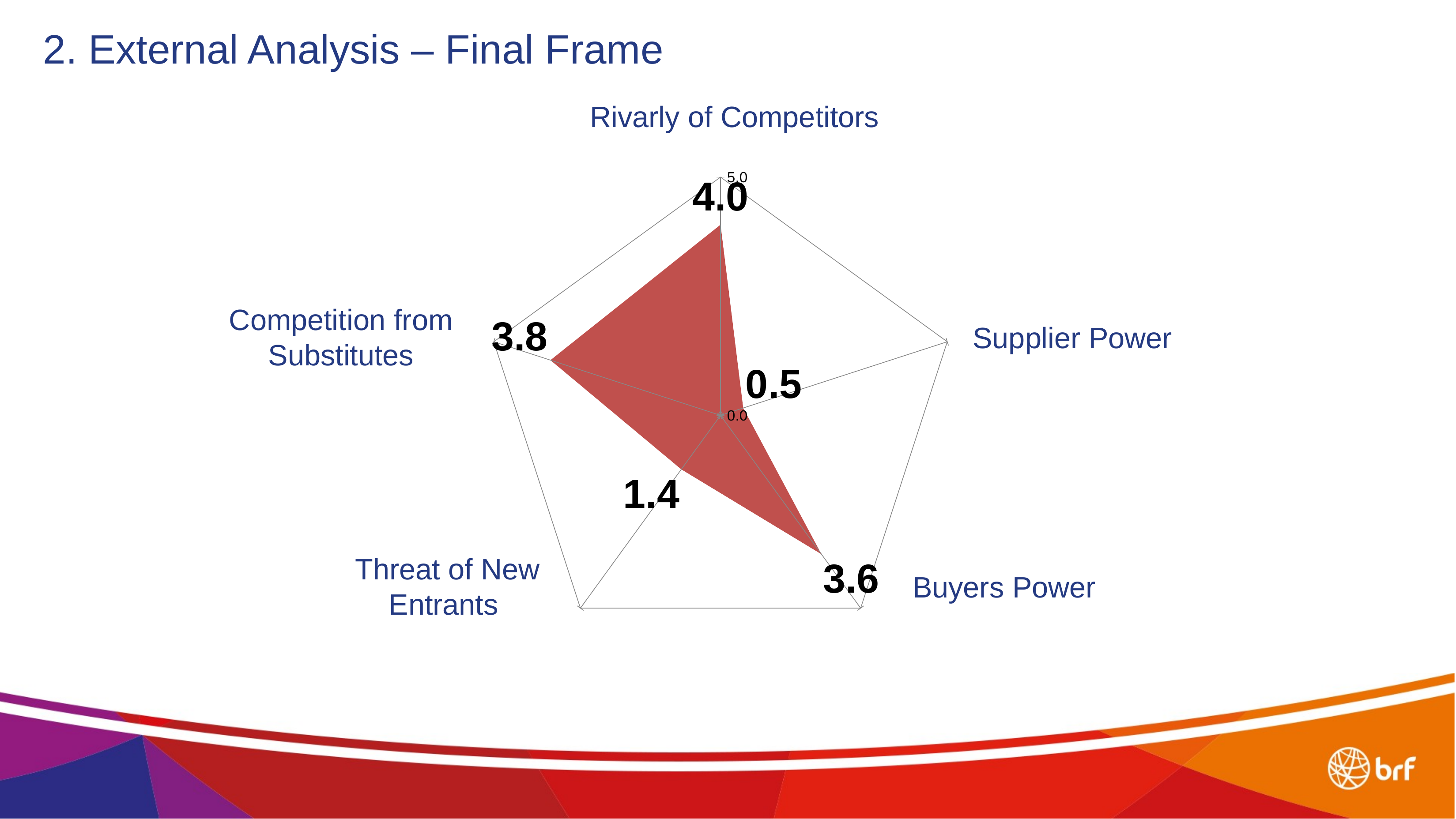
What is the difference between the values for Competition from Substitutes and Threat of New Entrants? 2.4 What kind of chart is shown on the slide? Radar chart What is the difference between the values for Rivarly of Competitors and Supplier Power? 3.5 Which category has the lowest value? Supplier Power What is the value for Supplier Power? 0.5 What is the value for Competition from Substitutes? 3.8 How many categories are plotted on the chart? 5 What is the value for Rivarly of Competitors? 4.0 What is the value for Threat of New Entrants? 1.4 What is the value for Buyers Power? 3.6 Which category has the highest value? Rivarly of Competitors Which is larger, the value for Buyers Power or the value for Threat of New Entrants? Buyers Power